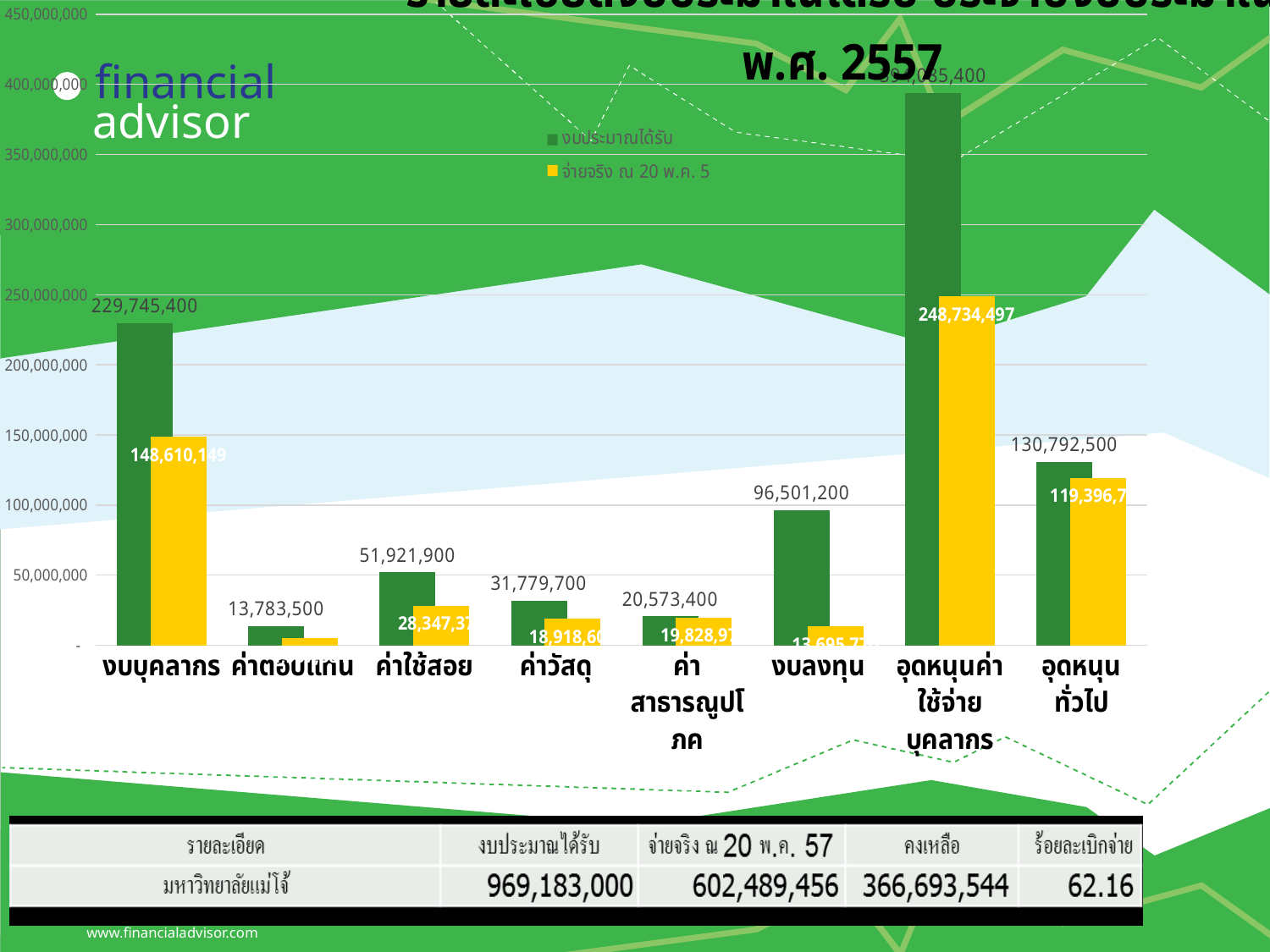
What is the difference between the งบประมาณได้รับ values for ค่าใช้สอย and ค่าวัสดุ? 20,142,200 Which has the larger งบประมาณได้รับ value, งบลงทุน or อุดหนุนทั่วไป? อุดหนุนทั่วไป How many series does the legend list? 2 What is the งบประมาณได้รับ value for งบบุคลากร? 229,745,400 What is the จ่ายจริง value for อุดหนุนค่าใช้จ่ายบุคลากร? 248,734,497 Which category has the lowest งบประมาณได้รับ value? ค่าตอบแทน What is the งบประมาณได้รับ value for ค่าตอบแทน? 13,783,500 Is the จ่ายจริง value for งบบุคลากร greater or less than 100,000,000? greater How many categories are shown on the x axis? 8 What is the งบประมาณได้รับ value for งบลงทุน? 96,501,200 What kind of chart is shown? bar chart Which category has the highest งบประมาณได้รับ value? อุดหนุนค่าใช้จ่ายบุคลากร